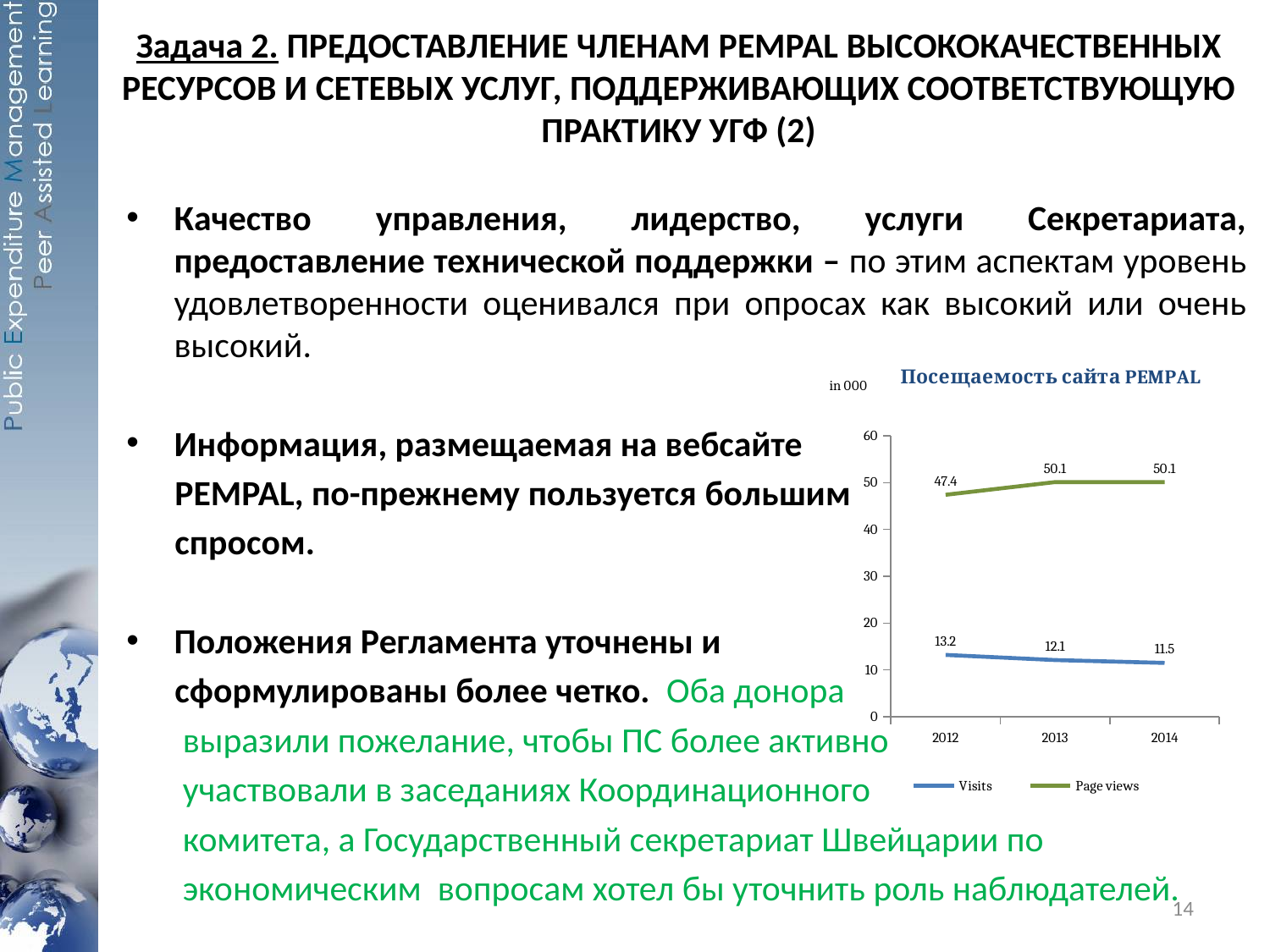
In which year is the Visits value lowest? 2014 What is the value of Visits in 2012? 13.2 What is the value of Page views in 2013? 50.1 What is the title of the chart? Посещаемость сайта PEMPAL How many years are shown on the x axis? 3 In which year is the Page views value lowest? 2012 How many series does the chart legend list? 2 What is the difference between Page views and Visits in 2012? 34.2 Do the Visits values rise or fall from 2012 to 2014? fall What is the value of Visits in 2014? 11.5 Which series has the higher value in 2014, Visits or Page views? Page views What type of chart is shown on the slide? line chart